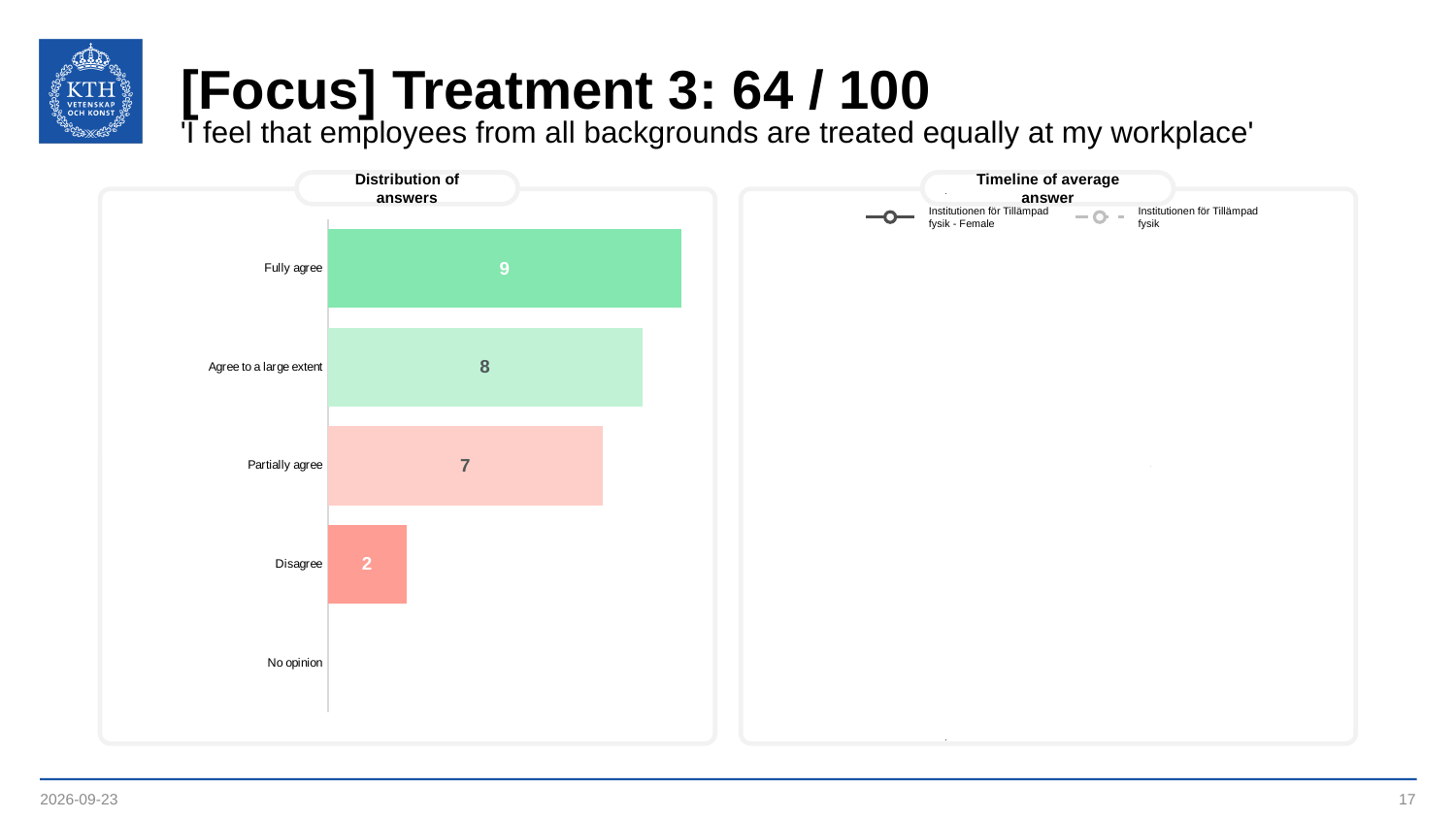
In the 'Distribution of answers' chart, which is larger: the value for 'Partially agree' or the value for 'Disagree'? Partially agree In the 'Distribution of answers' chart, what is the difference between the values for 'Fully agree' and 'Disagree'? 7 In the 'Distribution of answers' chart, what is the value for 'Agree to a large extent'? 8 In the 'Distribution of answers' chart, which category has the highest value? Fully agree How many answer categories are listed on the y axis of the 'Distribution of answers' chart? 5 In the 'Distribution of answers' chart, what is the value for 'Partially agree'? 7 In the 'Distribution of answers' chart, what is the value for 'Fully agree'? 9 How many series does the legend of the 'Timeline of average answer' chart list? 2 What is the title of the chart on the left side of the slide? Distribution of answers In the 'Distribution of answers' chart, what is the value for 'Disagree'? 2 What kind of chart is the 'Distribution of answers' chart? Bar chart In the 'Distribution of answers' chart, what is the difference between the values for 'Agree to a large extent' and 'Partially agree'? 1